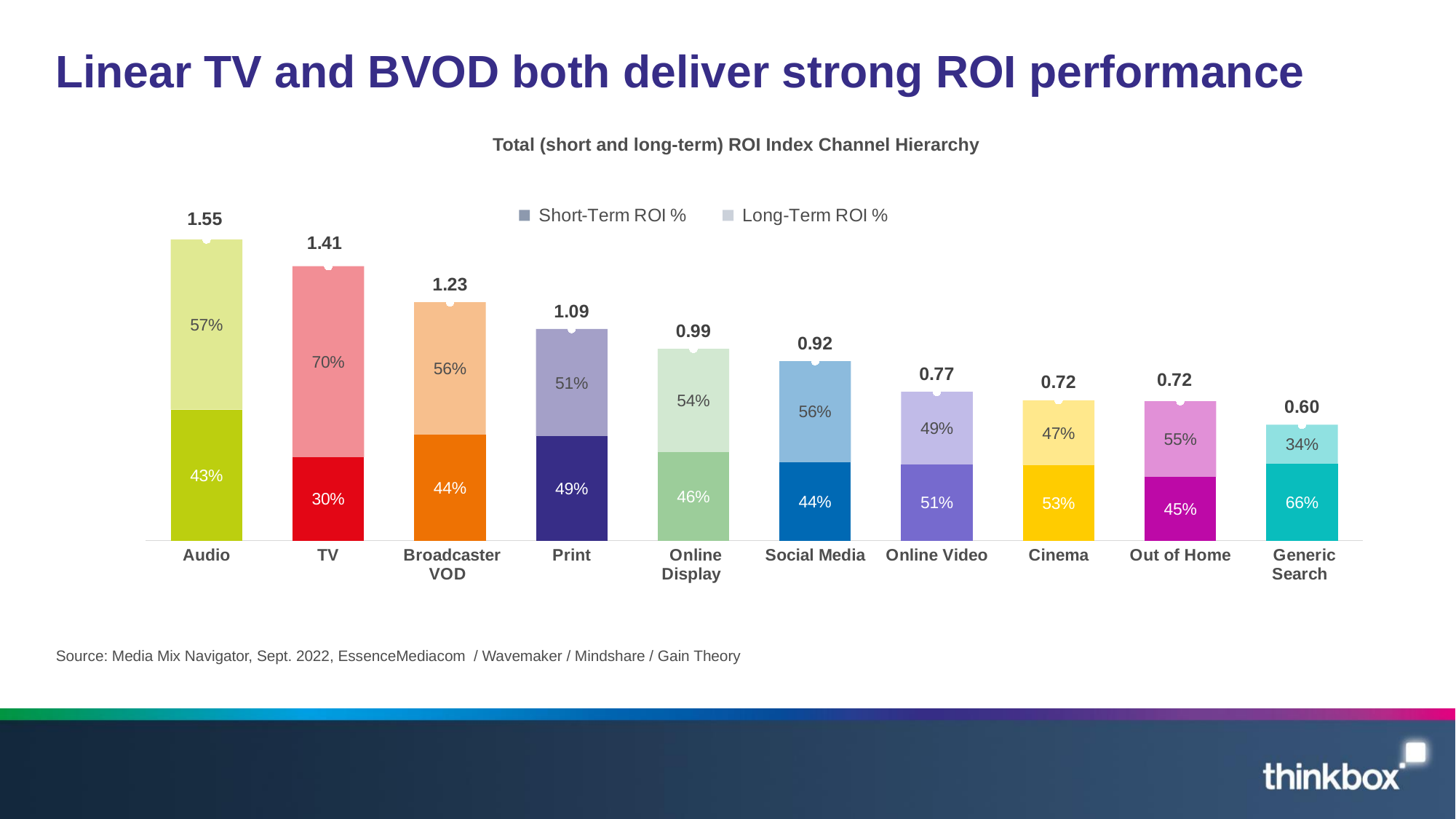
What is the difference between the total ROI index for Audio and for TV? 0.14 What is the Long-Term ROI % label shown for Broadcaster VOD? 56% Which channel has the highest total ROI index? Audio What is the total ROI index shown above the Audio bar? 1.55 What is the title of the chart? Total (short and long-term) ROI Index Channel Hierarchy How many series does the legend list? 2 What is the Short-Term ROI % label shown for TV? 30% How many channels are shown on the x axis? 10 What is the Short-Term ROI % label shown for Generic Search? 66% What kind of chart is shown on the slide? Stacked bar chart Which has a higher total ROI index, Print or Social Media? Print Which channel has the lowest total ROI index? Generic Search